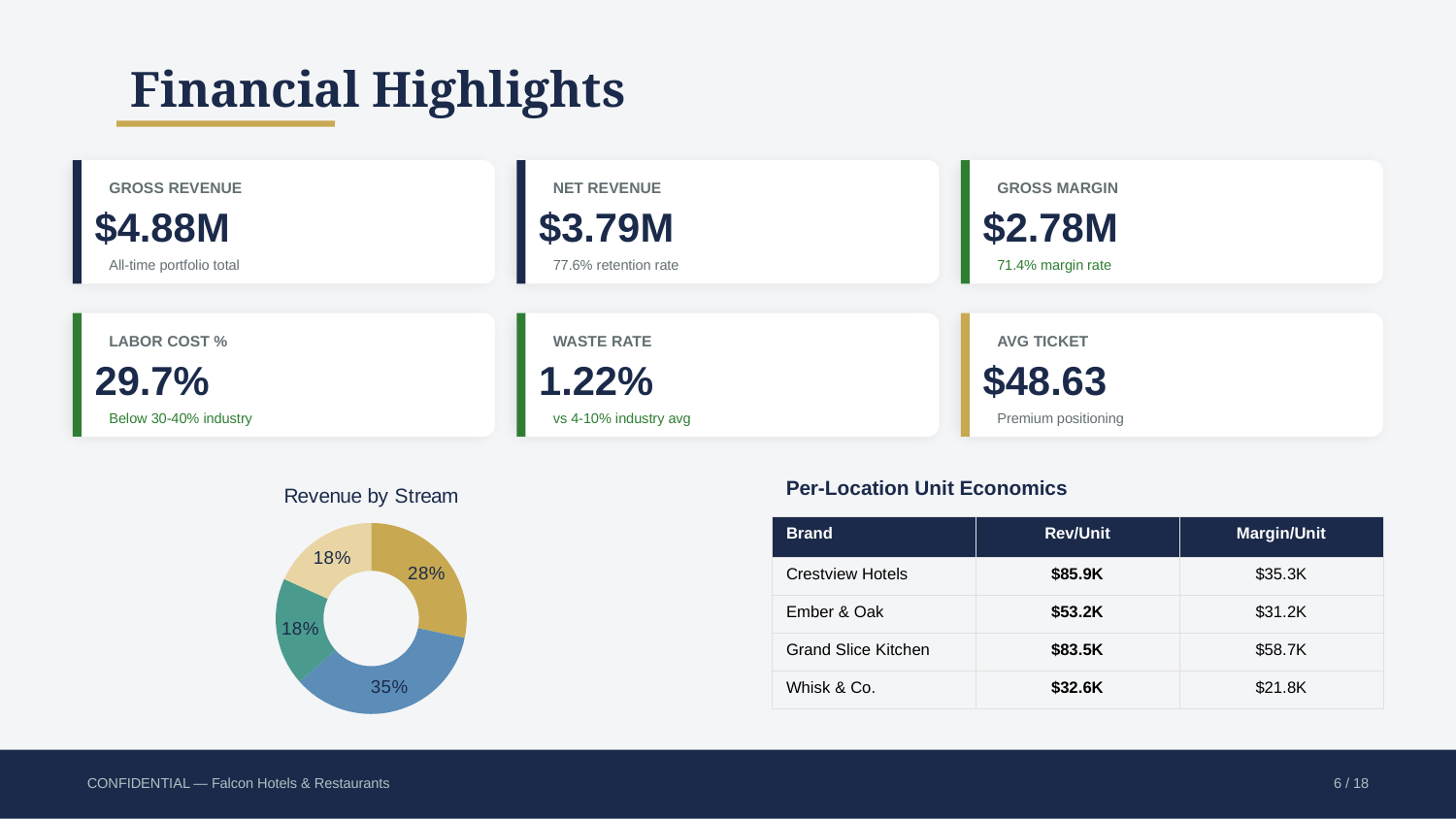
In the Revenue by Stream chart, how many slices are labelled 18%? 2 How many slices does the Revenue by Stream chart have? 4 What is the title of the chart on the slide? Revenue by Stream In the Revenue by Stream chart, what is the difference in percentage points between the largest slice and the gold slice? 7 percentage points What kind of chart is the Revenue by Stream chart? Donut (pie) chart In the Revenue by Stream chart, what is the share of the smallest slices? 18% In the Revenue by Stream chart, what is the share of the largest slice? 35% In the Revenue by Stream chart, what share does the teal (green) slice represent? 18% In the Revenue by Stream chart, what is the combined share of the two 18% slices? 36% In the Revenue by Stream chart, which slice is larger: the blue slice or the gold slice? The blue slice In the Revenue by Stream chart, what share does the gold slice represent? 28% In the Revenue by Stream chart, what share does the blue slice represent? 35%